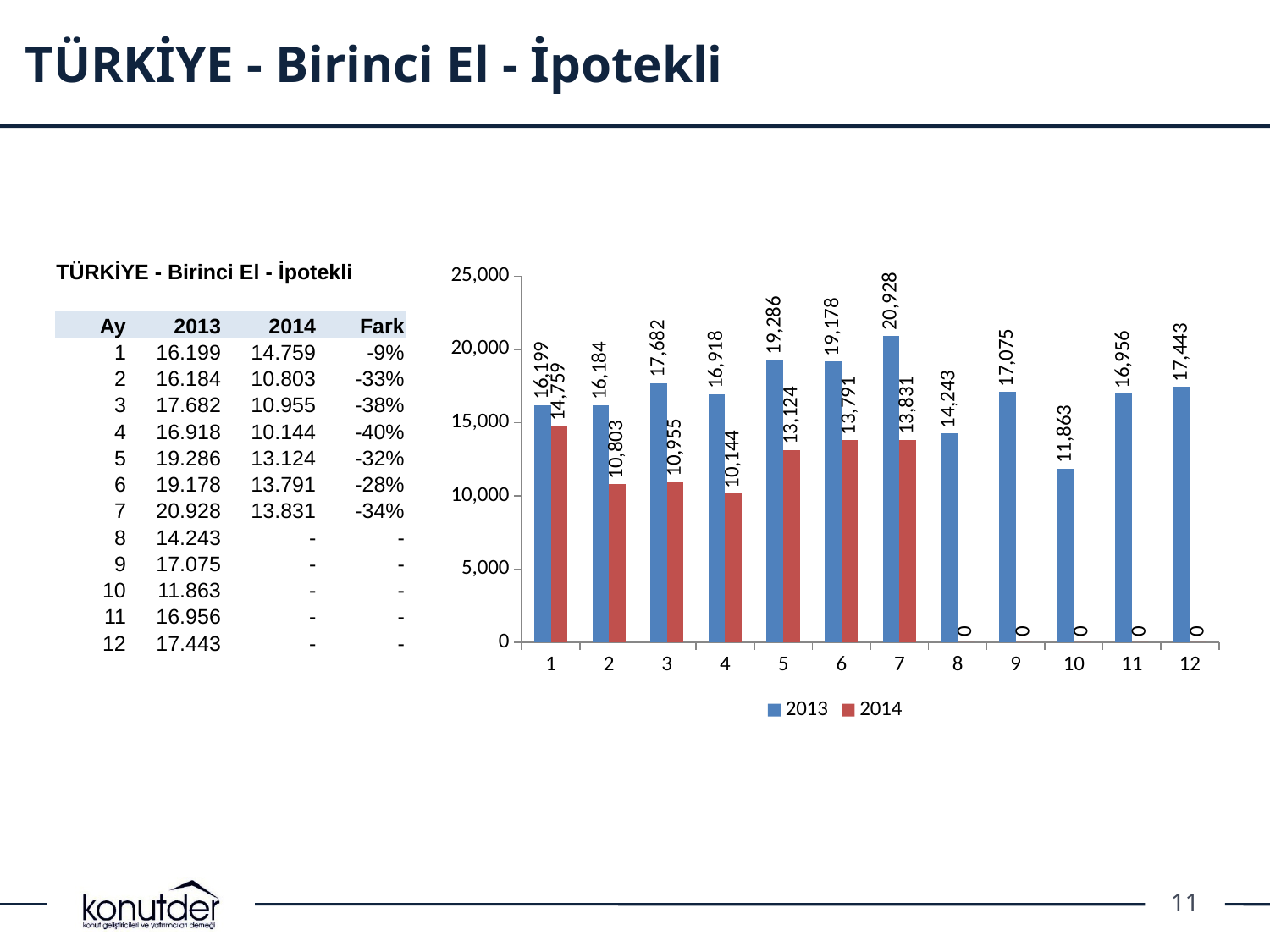
What is the 2013 value for month 7? 20,928 What is the 2014 value for month 4? 10,144 How many series does the legend list? 2 Which month has the highest 2014 value? 1 What is the 2013 value for month 10? 11,863 Which month has the lowest 2013 value? 10 What is the difference between the 2013 and 2014 values for month 7? 7,097 What is the difference between the 2013 and 2014 values for month 1? 1,440 How many months are shown on the x axis? 12 Which month has the highest 2013 value? 7 Is the 2013 value for month 12 greater or less than 15,000? greater Which is larger, the 2013 value for month 9 or the 2013 value for month 10? month 9